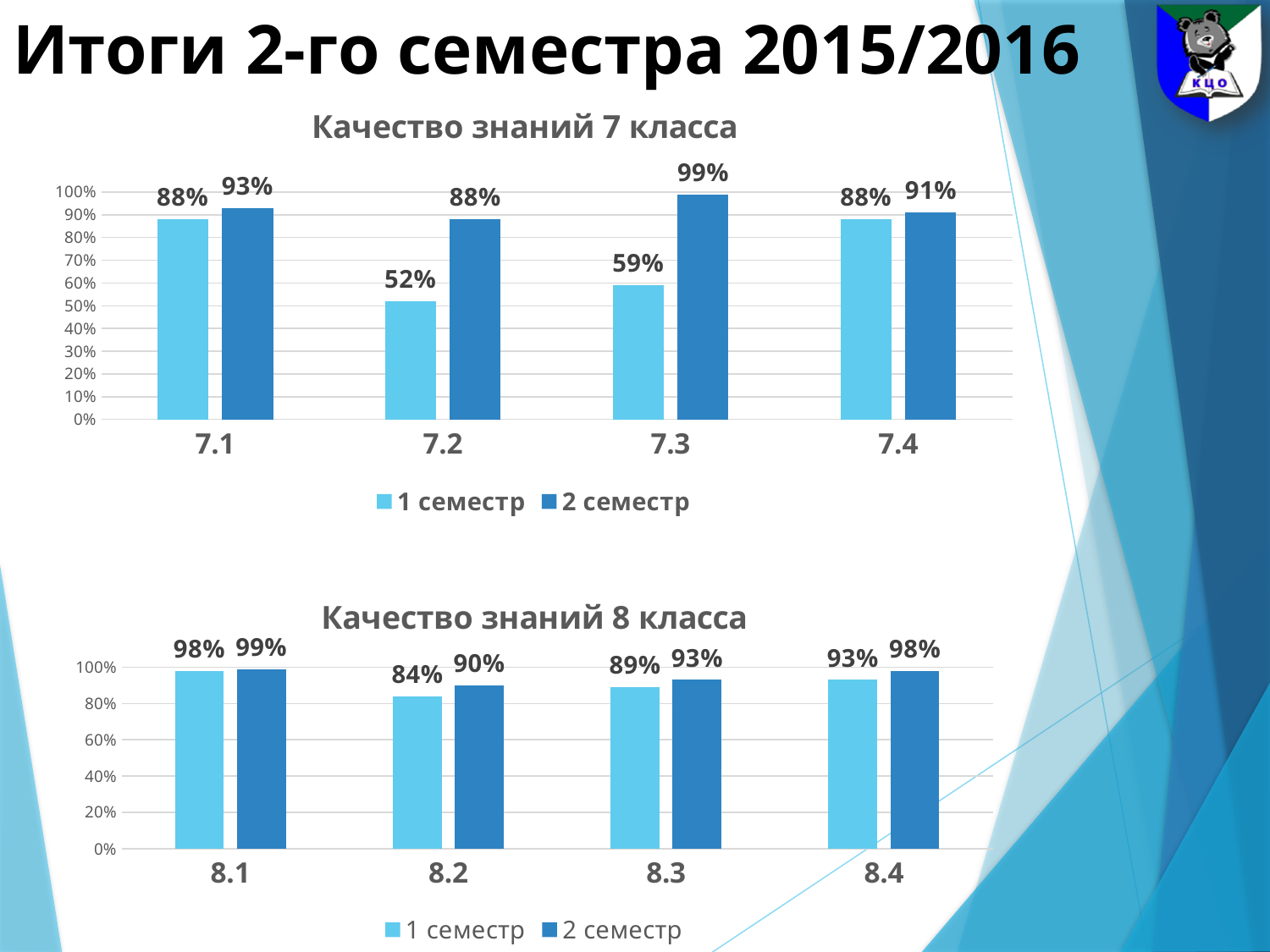
In the chart 'Качество знаний 7 класса', how many series does the legend list? 2 In the chart 'Качество знаний 7 класса', what is the difference between the '2 семестр' and '1 семестр' values for 7.3? 40% What kind of chart is 'Качество знаний 8 класса'? bar chart In the chart 'Качество знаний 7 класса', what is the value for 7.3 in the '2 семестр' series? 99% In the chart 'Качество знаний 8 класса', what is the difference between the '2 семестр' and '1 семестр' values for 8.2? 6% In the chart 'Качество знаний 8 класса', what is the value for 8.2 in the '1 семестр' series? 84% In the chart 'Качество знаний 8 класса', what is the value for 8.4 in the '2 семестр' series? 98% In the chart 'Качество знаний 7 класса', which category has the lowest '1 семестр' value? 7.2 In the chart 'Качество знаний 7 класса', what is the value for 7.2 in the '1 семестр' series? 52% In the chart 'Качество знаний 8 класса', which category has the highest '2 семестр' value? 8.1 In the chart 'Качество знаний 8 класса', which is larger: the '1 семестр' value for 8.3 or the '1 семестр' value for 8.4? 8.4 In the chart 'Качество знаний 7 класса', how many categories are shown on the x axis? 4